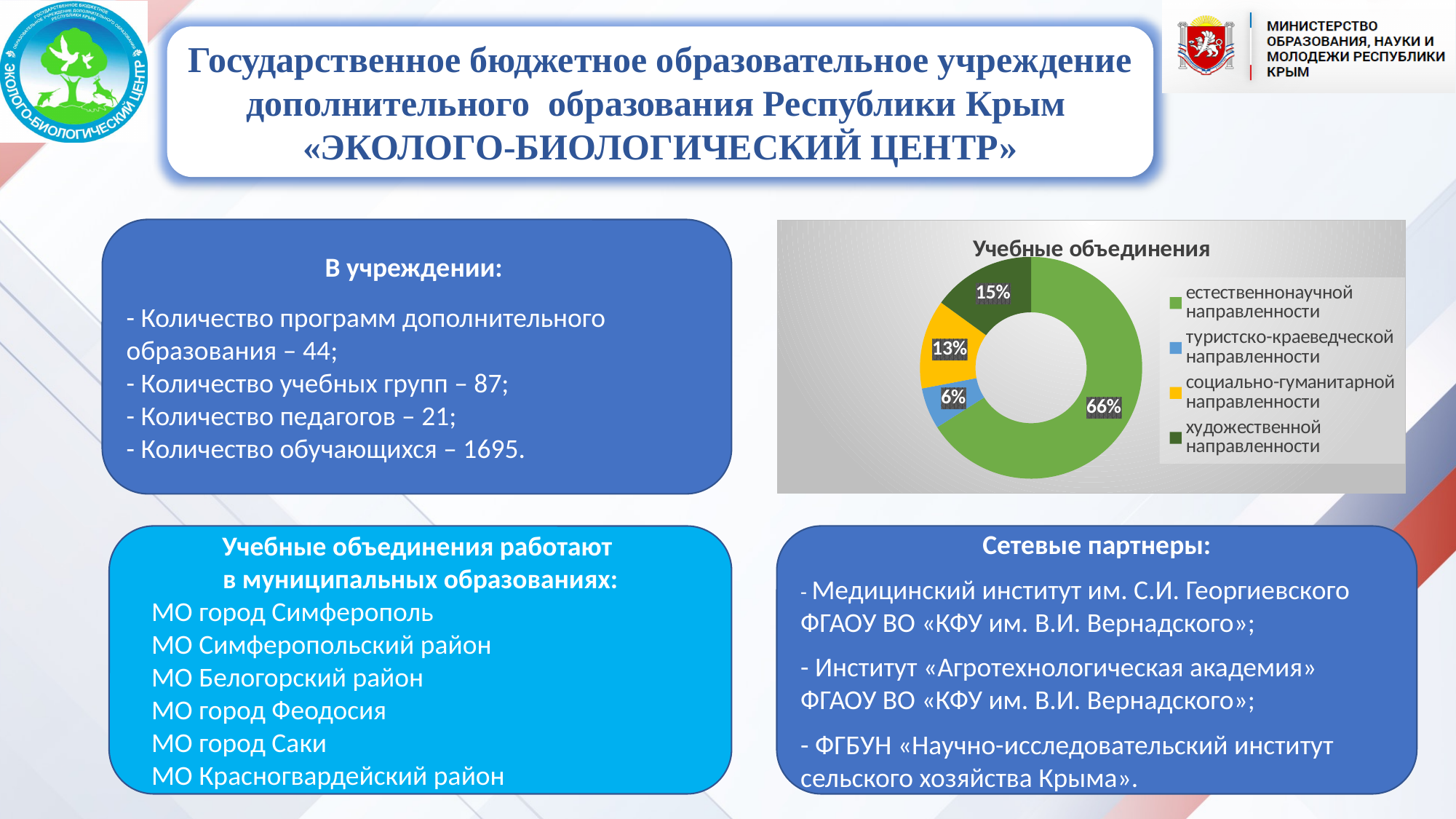
What share of the chart is taken by художественной направленности? 15% How many categories does the chart show? 4 What colour represents социально-гуманитарной направленности in the chart? yellow Which category has the smallest share in the chart? туристско-краеведческой направленности What is the title of the chart on the slide? Учебные объединения What is the difference in percentage points between художественной направленности and социально-гуманитарной направленности? 2 Which category has the largest share in the chart? естественнонаучной направленности What share of the chart is taken by туристско-краеведческой направленности? 6% What share of the chart is taken by социально-гуманитарной направленности? 13% Which is larger: the share of художественной направленности or социально-гуманитарной направленности? художественной направленности What type of chart is shown on the slide? doughnut chart